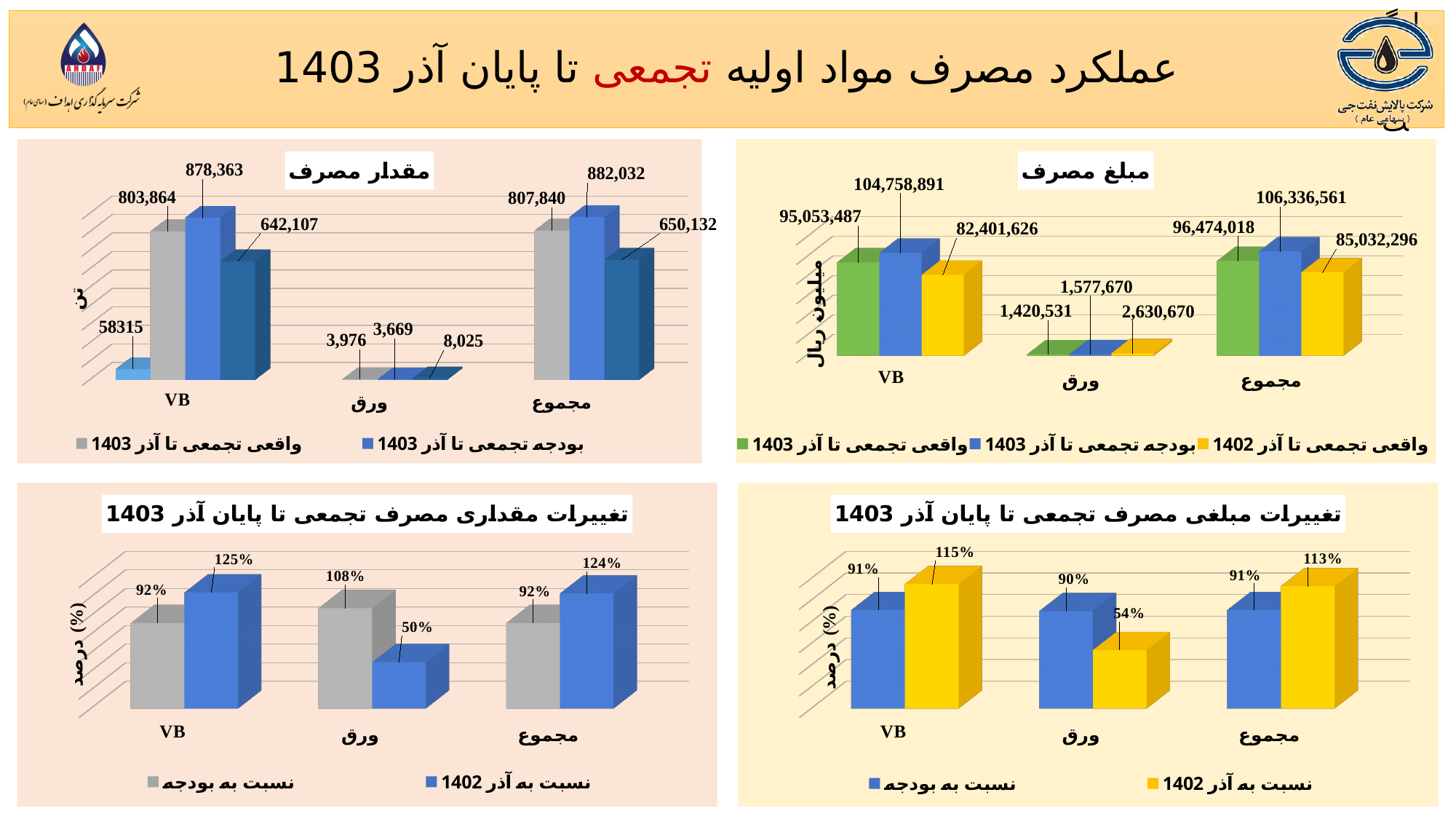
In the top-right chart (مبلغ مصرف), what is the difference between the بودجه تجمعی تا آذر 1403 value and the واقعی تجمعی تا آذر 1403 value for مجموع? 9,862,543 In the top-right chart (مبلغ مصرف), what is the value of the بودجه تجمعی تا آذر 1403 series for VB? 104,758,891 What kind of chart is the bottom-right chart (تغییرات مبلغی)? Bar chart In the bottom-right chart (تغییرات مبلغی), which category has the highest value for the نسبت به آذر 1402 series? VB In the top-right chart (مبلغ مصرف), what is the value of the تا آذر 1402 series for مجموع? 85,032,296 In the bottom-left chart (تغییرات مقداری), what is the value of نسبت به آذر 1402 for ورق? 50% In the top-left chart (مقدار مصرف), what is the value of the واقعی تجمعی تا آذر 1403 series for مجموع? 807,840 How many series does the legend of the top-right chart (مبلغ مصرف) list? 3 In the top-left chart (مقدار مصرف), what is the value of the بودجه تجمعی تا آذر 1403 series for ورق? 3,669 In the bottom-right chart (تغییرات مبلغی), what is the value of نسبت به بودجه for VB? 91% In the bottom-left chart (تغییرات مقداری), which category has the lowest value for the نسبت به آذر 1402 series? ورق In the bottom-left chart (تغییرات مقداری), which is larger for VB: نسبت به بودجه or نسبت به آذر 1402? نسبت به آذر 1402